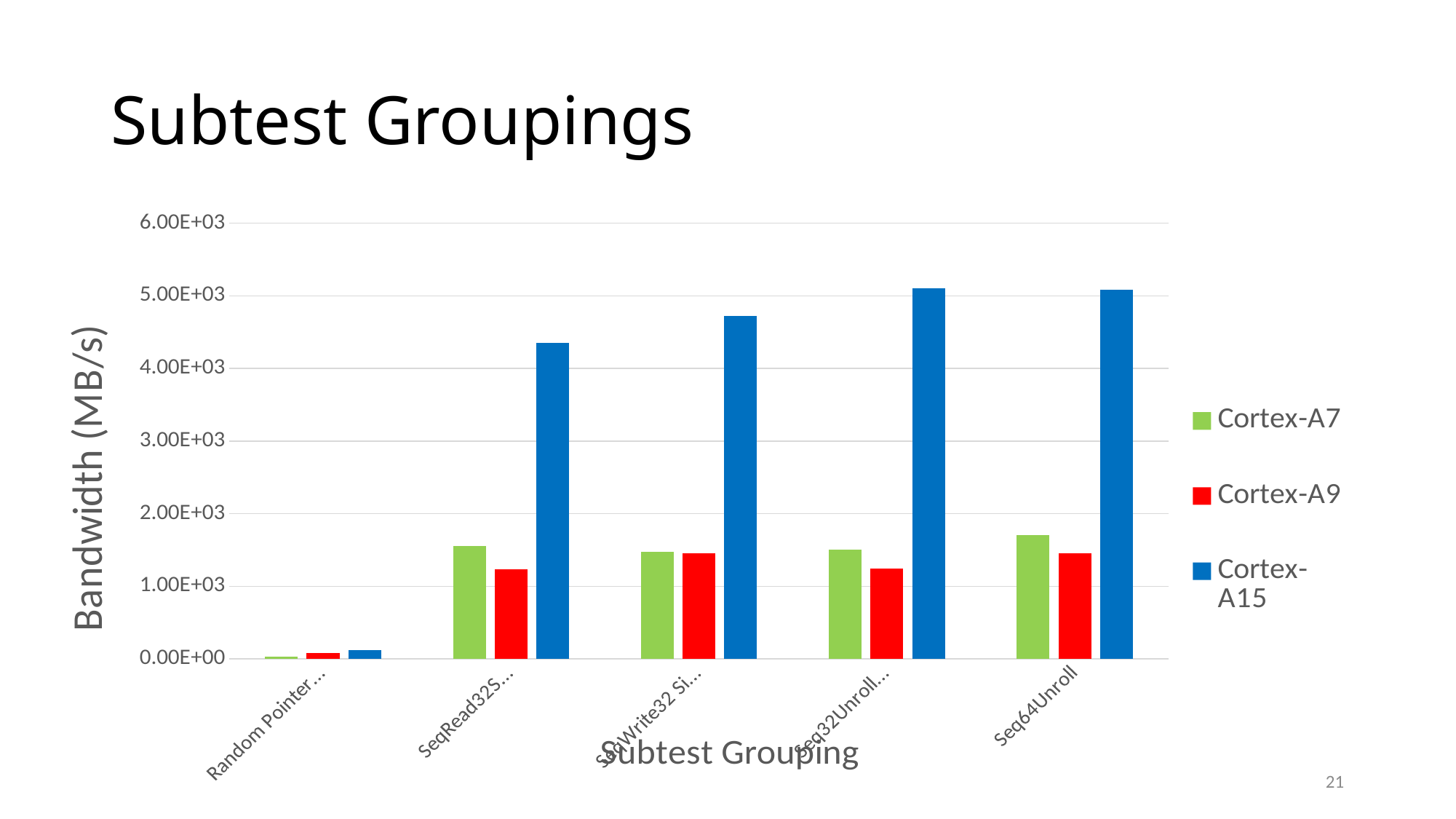
Which category has the lowest Cortex-A15 bandwidth? Random Pointer Which series has the highest bandwidth for Seq64Unroll? Cortex-A15 Which colour represents Cortex-A9 in the legend? red How many subtest grouping categories are shown on the x axis? 5 Is the Cortex-A7 value for Seq64Unroll greater or less than 2.00E+03? less For Random Pointer, which is larger: the Cortex-A7 value or the Cortex-A15 value? Cortex-A15 What is the label of the y axis? Bandwidth (MB/s) What kind of chart is shown on the slide? bar chart Is the Cortex-A9 value for Random Pointer greater or less than 1.00E+03? less Is the Cortex-A15 value for Seq64Unroll greater or less than 4.00E+03? greater How many series does the legend list? 3 For Seq64Unroll, which is larger: the Cortex-A7 value or the Cortex-A9 value? Cortex-A7